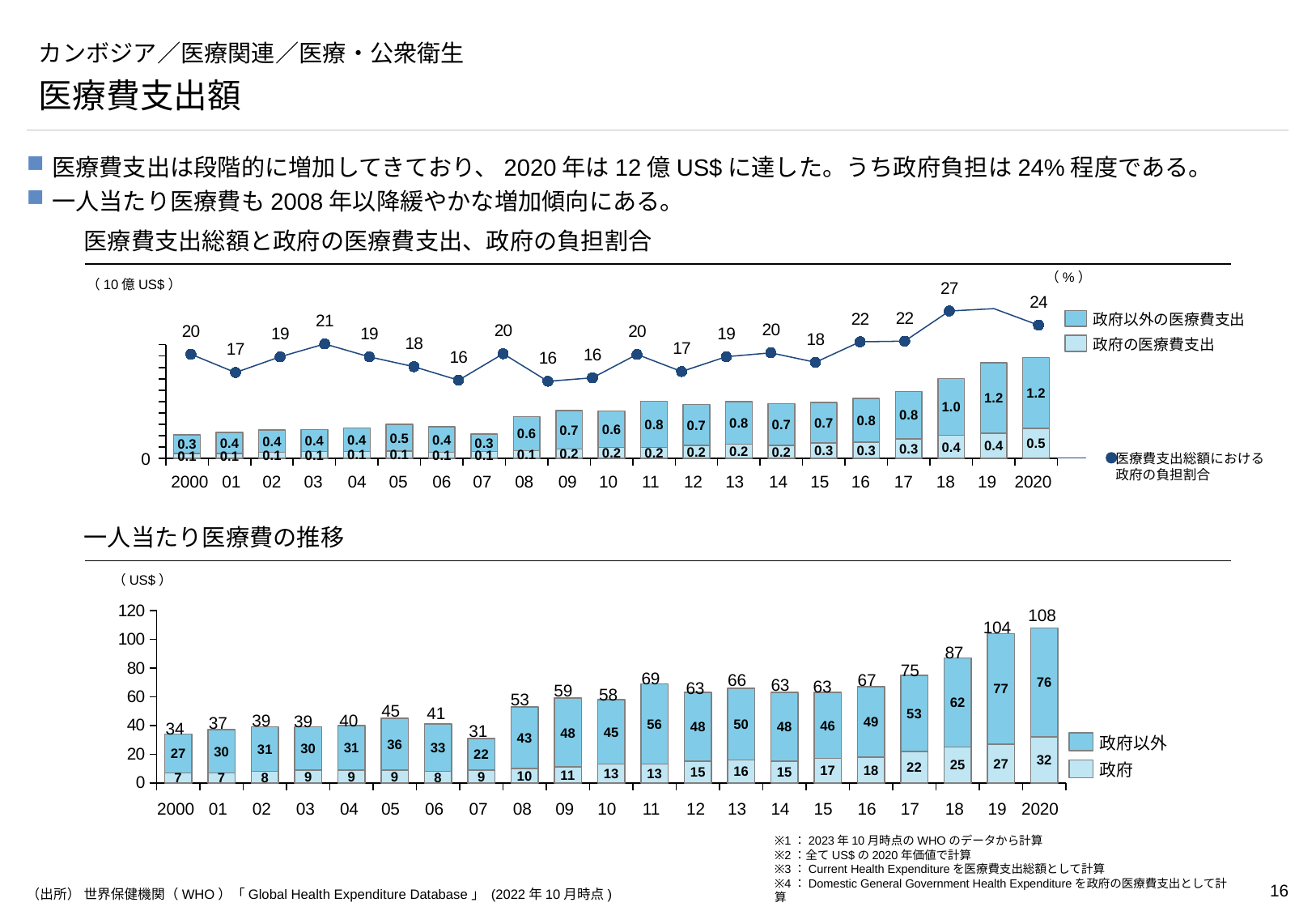
In the top chart, how many entries does the legend list? 3 In the top chart, what is the value of 政府の医療費支出 for 2020? 0.5 In the bottom chart (一人当たり医療費の推移), what is the total per-capita health expenditure for 2020? 108 In the bottom chart, what is the 政府 value for 2020? 32 In the top chart (医療費支出総額と政府の医療費支出、政府の負担割合), what is the value of 政府以外の医療費支出 for 2020? 1.2 In the bottom chart, which is larger: the 政府以外 value for 18 or for 17? 18 In the bottom chart, what is the difference between the total for 2020 and the total for 19? 4 In the bottom chart, how many years are shown on the x axis? 21 In the bottom chart, which year has the lowest total per-capita health expenditure? 07 What kind of chart is the bottom chart (一人当たり医療費の推移)? Stacked bar chart In the top chart, what is the government share (%) for 2018? 27